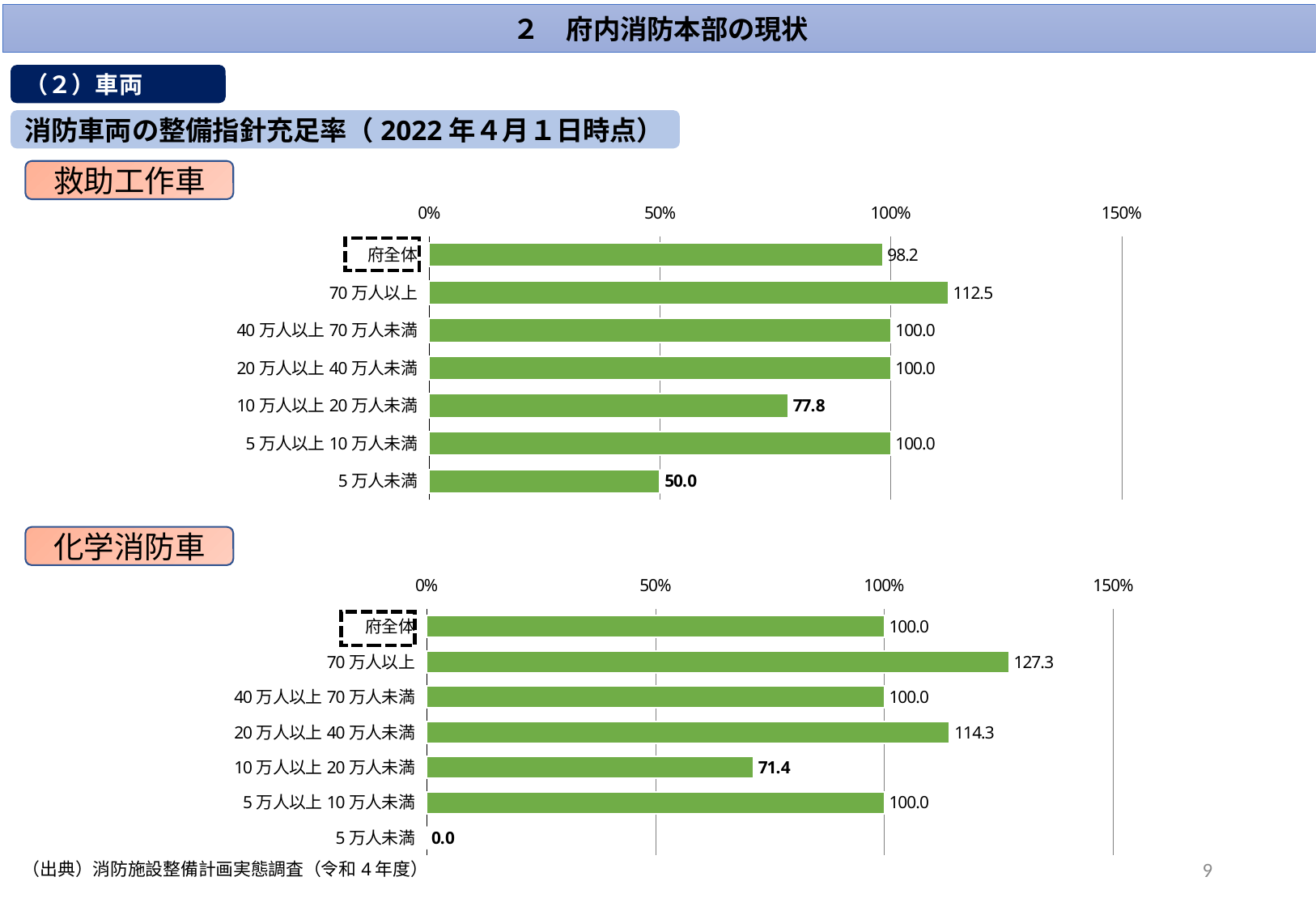
In the 化学消防車 chart, what is the value for 10万人以上20万人未満? 71.4 In the 救助工作車 chart, which category has the lowest value? 5万人未満 In the 救助工作車 chart, what is the difference between the values for 70万人以上 and 10万人以上20万人未満? 34.7 In the 化学消防車 chart, which category has the highest value? 70万人以上 In the 化学消防車 chart, is the value for 70万人以上 larger or smaller than the value for 20万人以上40万人未満? larger In the 化学消防車 chart, which category has the lowest value? 5万人未満 In the 化学消防車 chart, what is the value for 20万人以上40万人未満? 114.3 In the 化学消防車 chart, what is the difference between the values for 府全体 and 10万人以上20万人未満? 28.6 What type of chart is the 救助工作車 chart? bar chart In the 救助工作車 chart, how many categories are plotted? 7 In the 救助工作車 chart, which category has the highest value? 70万人以上 In the 救助工作車 chart, what is the value for 府全体? 98.2